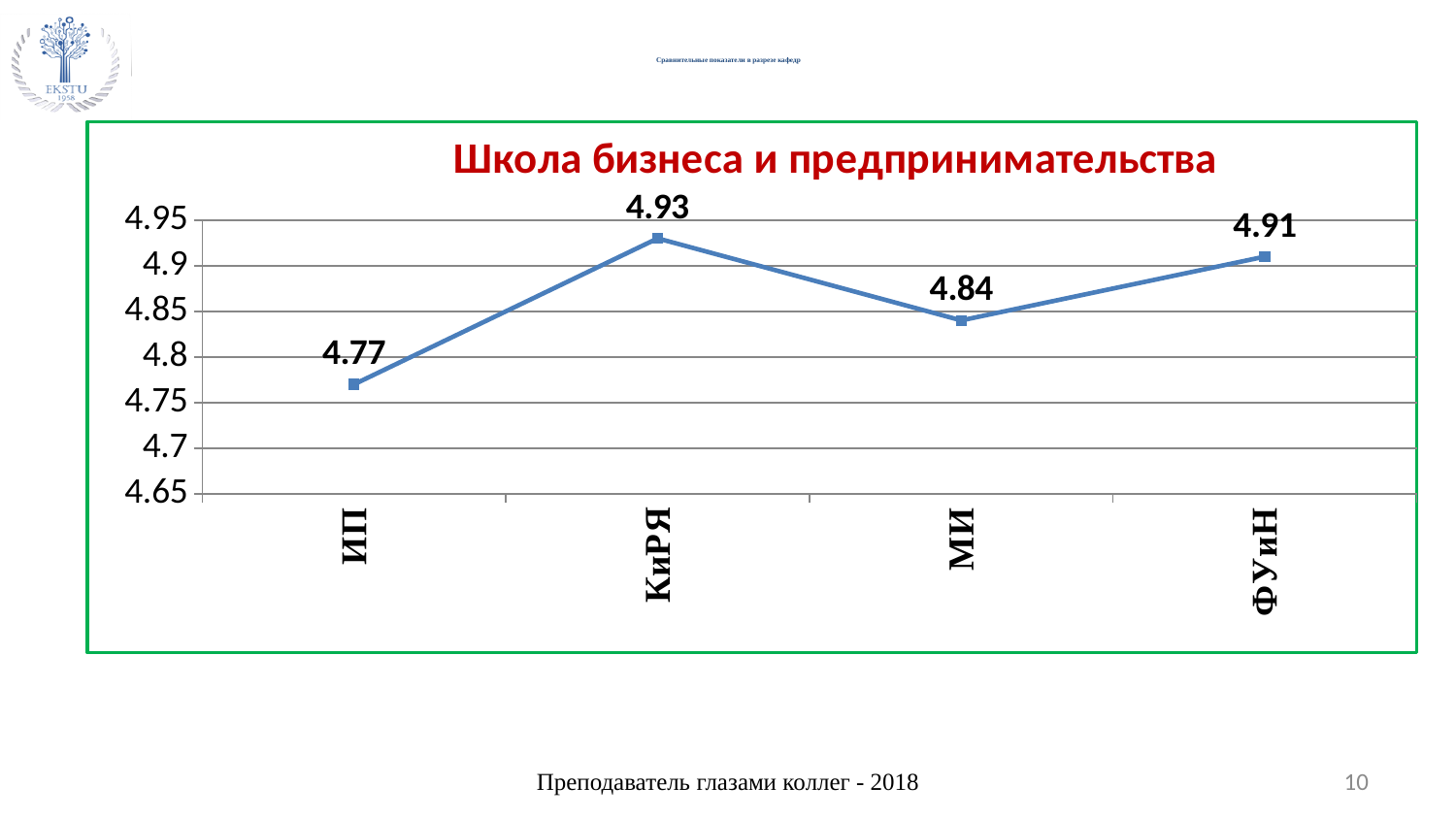
What is the value for ФУиН? 4.91 What is the value for МИ? 4.84 Which category has the highest value? КиРЯ Which category has the lowest value? ИП What is the value for ИП? 4.77 Is the value for МИ greater or less than 4.8? greater What is the difference between the values for КиРЯ and ИП? 0.16 Which is larger, the value for МИ or the value for ФУиН? ФУиН What kind of chart is shown? line chart What is the title of the chart? Школа бизнеса и предпринимательства How many categories are plotted on the chart? 4 What is the value for КиРЯ? 4.93